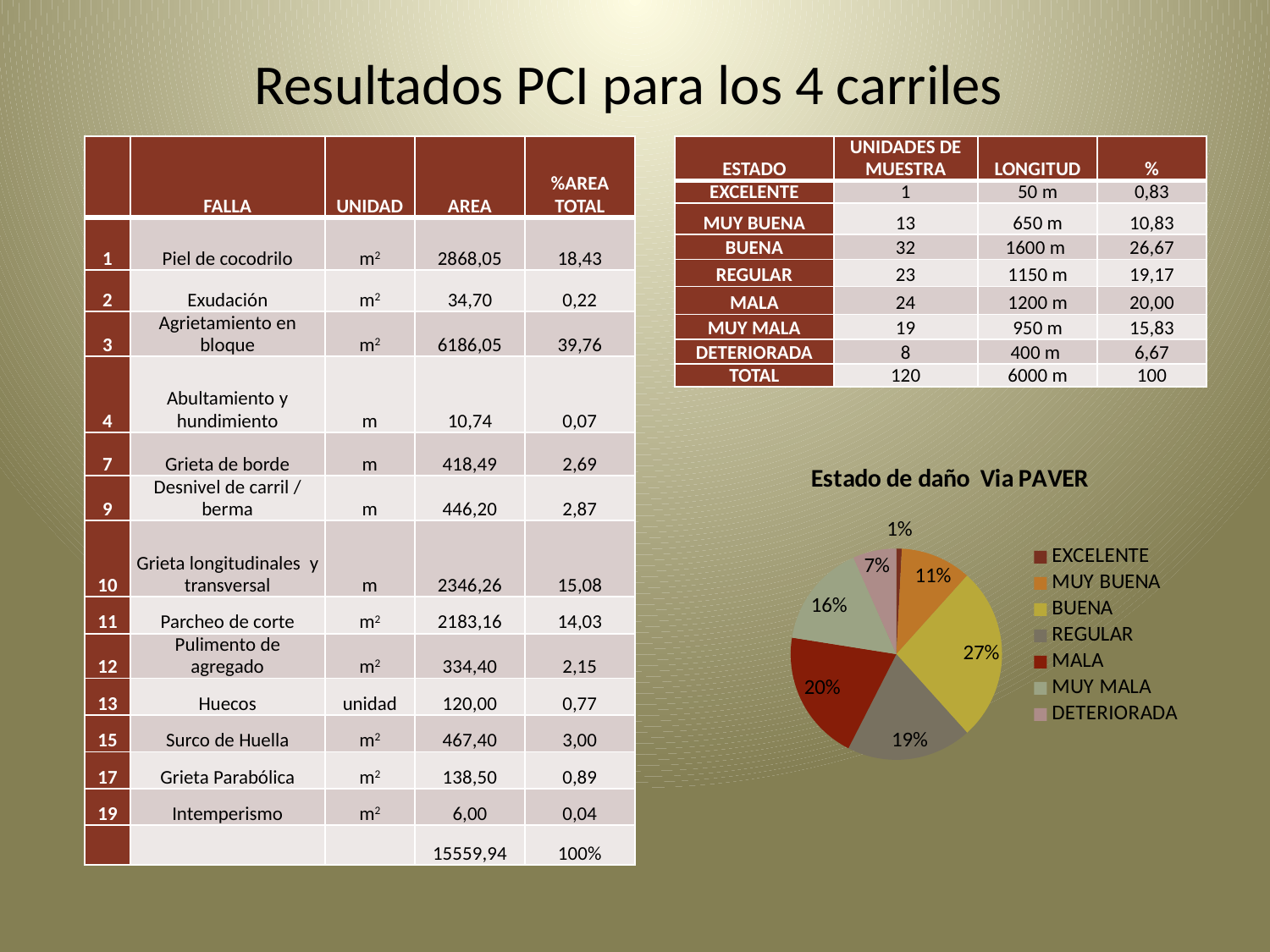
Which is larger in the pie chart, MUY BUENA or MUY MALA? MUY MALA What kind of chart is shown on the slide? pie chart What percentage is shown for MUY MALA in the pie chart? 16% What percentage is shown for DETERIORADA in the pie chart? 7% What is the title of the pie chart? Estado de daño Via PAVER What percentage is shown for MALA in the pie chart? 20% Which category has the largest slice in the pie chart? BUENA How many slices does the pie chart have? 7 How many entries does the legend of the pie chart list? 7 What is the difference in percentage points between BUENA and REGULAR in the pie chart? 8 What share of the pie does BUENA represent? 27% Which category has the smallest slice in the pie chart? EXCELENTE